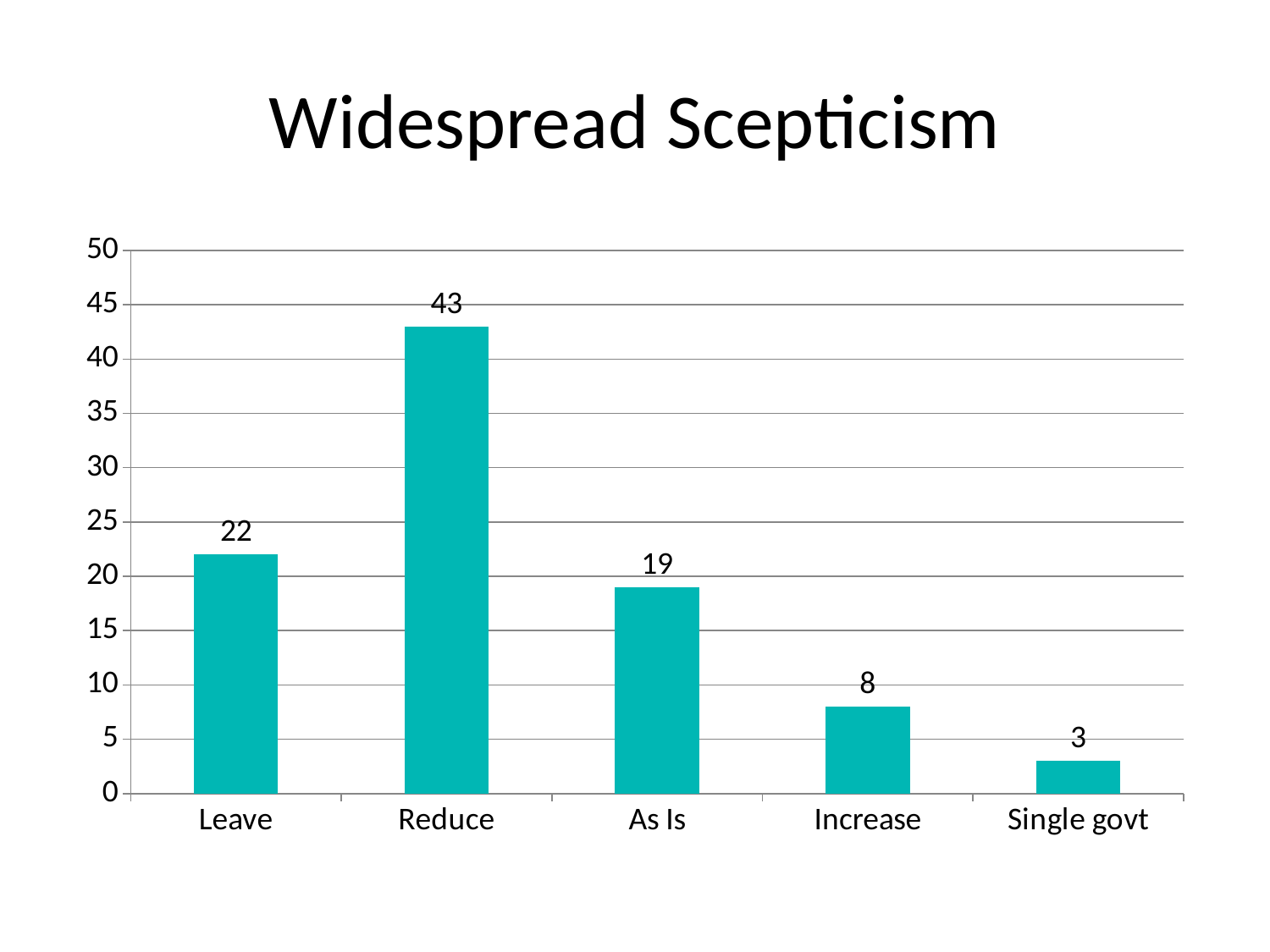
What is the value for Increase? 8 How many categories are shown on the x axis? 5 Is the value for As Is greater or less than 20? less What is the difference between the values for As Is and Increase? 11 What is the difference between the values for Reduce and Leave? 21 What is the value for Leave? 22 What is the value for Reduce? 43 Which is larger, the value for Leave or the value for As Is? Leave What is the value for Single govt? 3 Which category has the highest value? Reduce What kind of chart is shown on the slide? bar chart Which category has the lowest value? Single govt